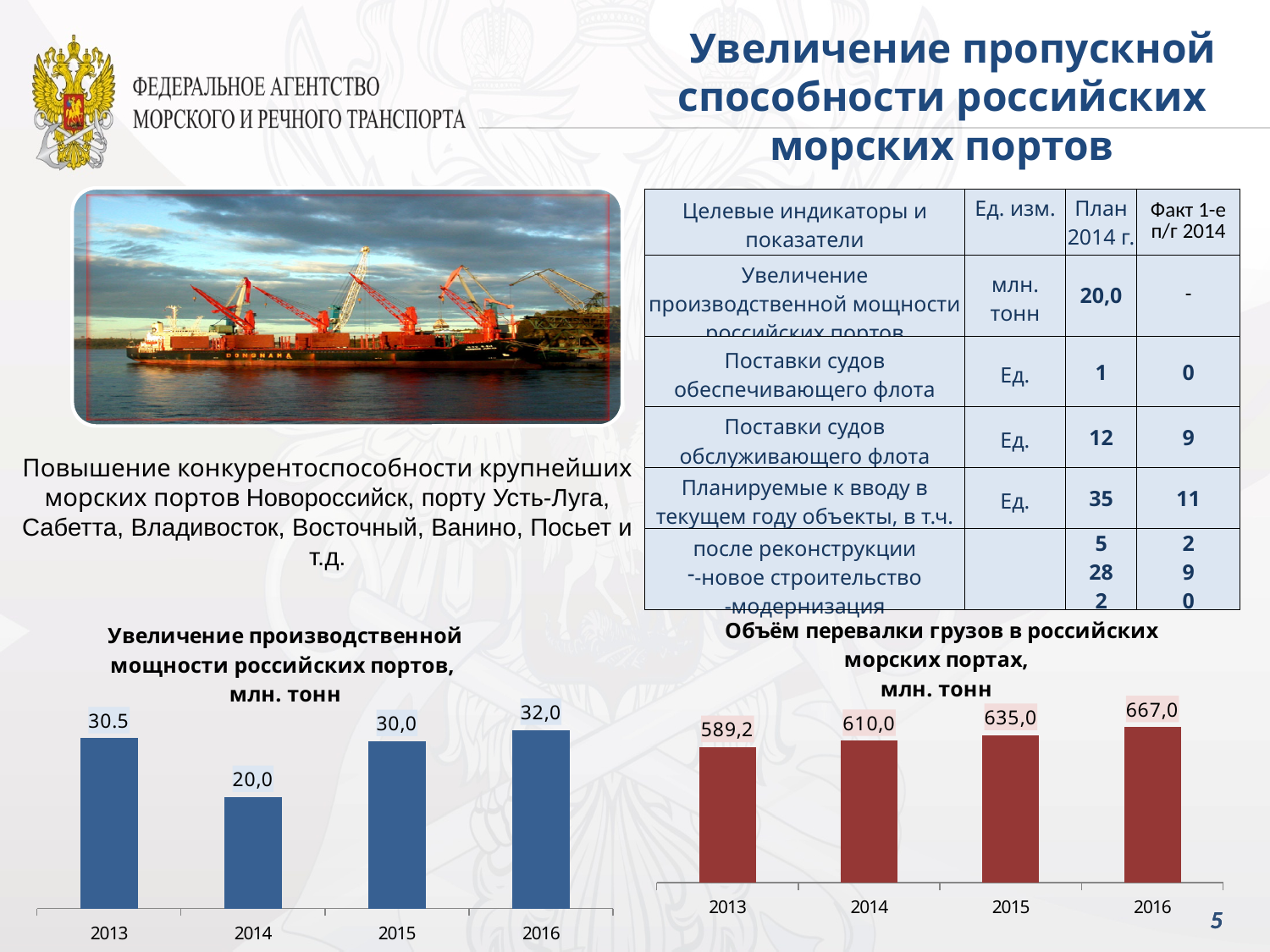
In the right chart (Объём перевалки грузов в российских морских портах), which is larger, the value for 2014 or the value for 2015? 2015 In the left chart (Увеличение производственной мощности российских портов), how many bars are plotted? 4 In the left chart (Увеличение производственной мощности российских портов), which year has the lowest value? 2014 In the left chart (Увеличение производственной мощности российских портов), what is the value for 2013? 30.5 In the left chart (Увеличение производственной мощности российских портов), what is the difference between the 2016 and 2015 values? 2,0 In the right chart (Объём перевалки грузов в российских морских портах), do the values rise or fall from 2013 to 2016? rise What type of chart is the right chart (Объём перевалки грузов в российских морских портах)? bar chart In the left chart (Увеличение производственной мощности российских портов), what is the value for 2014? 20,0 In the right chart (Объём перевалки грузов в российских морских портах), what is the difference between the 2016 and 2013 values? 77,8 In the left chart (Увеличение производственной мощности российских портов), which year has the highest value? 2016 In the right chart (Объём перевалки грузов в российских морских портах), what is the value for 2016? 667,0 In the right chart (Объём перевалки грузов в российских морских портах), what is the value for 2015? 635,0